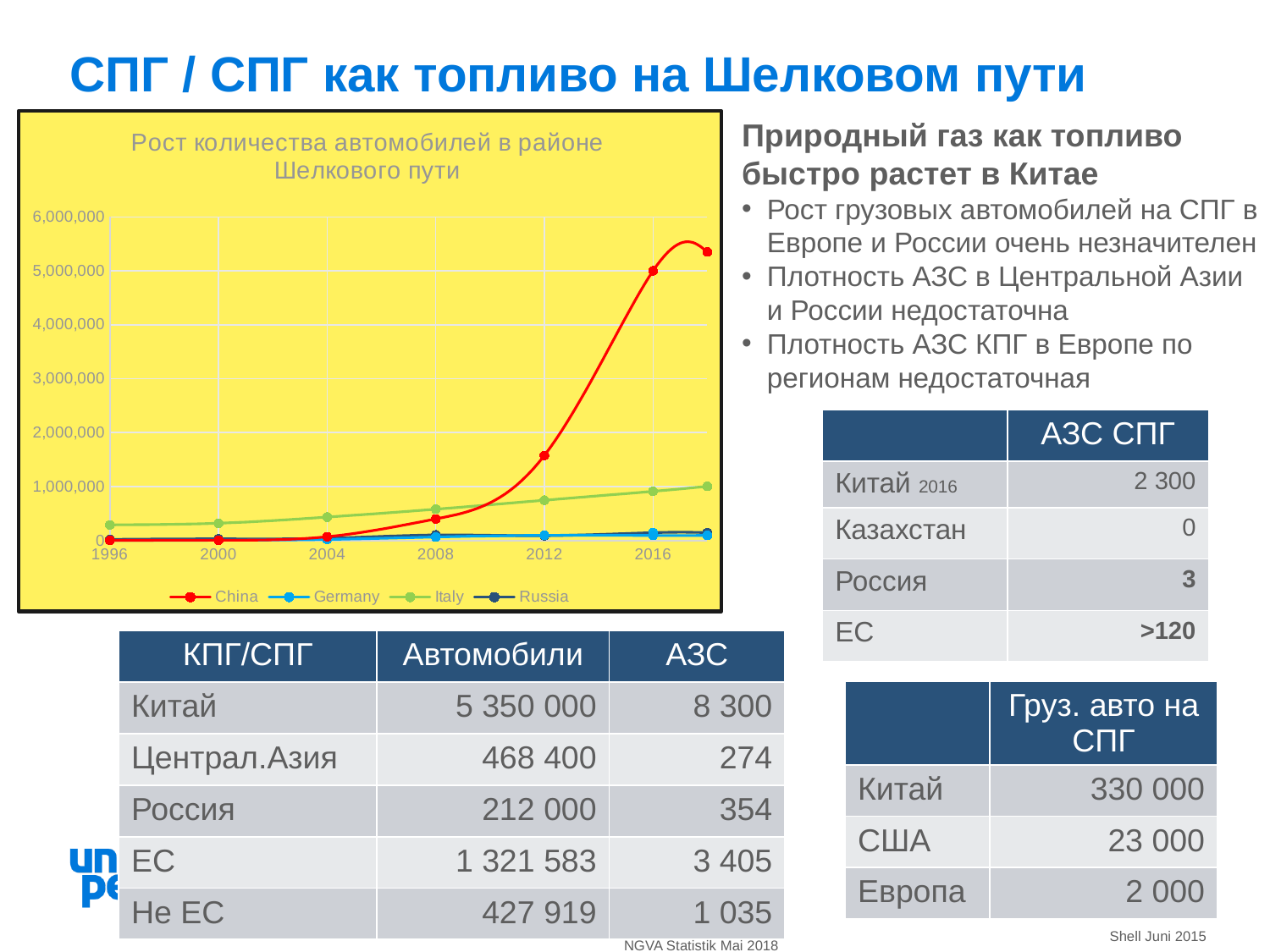
Is the value for China in 2008 greater or less than 1,000,000? less What colour is the line for China? red How many series does the chart legend list? 4 What is the title of the chart? Рост количества автомобилей в районе Шелкового пути Which is larger in 2016, the value for China or the value for Italy? China Is the value for China in 2012 greater or less than 1,000,000? greater What kind of chart is shown on the slide? line chart Is the value for China in 2016 greater or less than 4,000,000? greater Which series has the highest value in 2016? China Does the China series rise or fall from 1996 to 2016? rise Which is larger in 2004, the value for Italy or the value for China? Italy